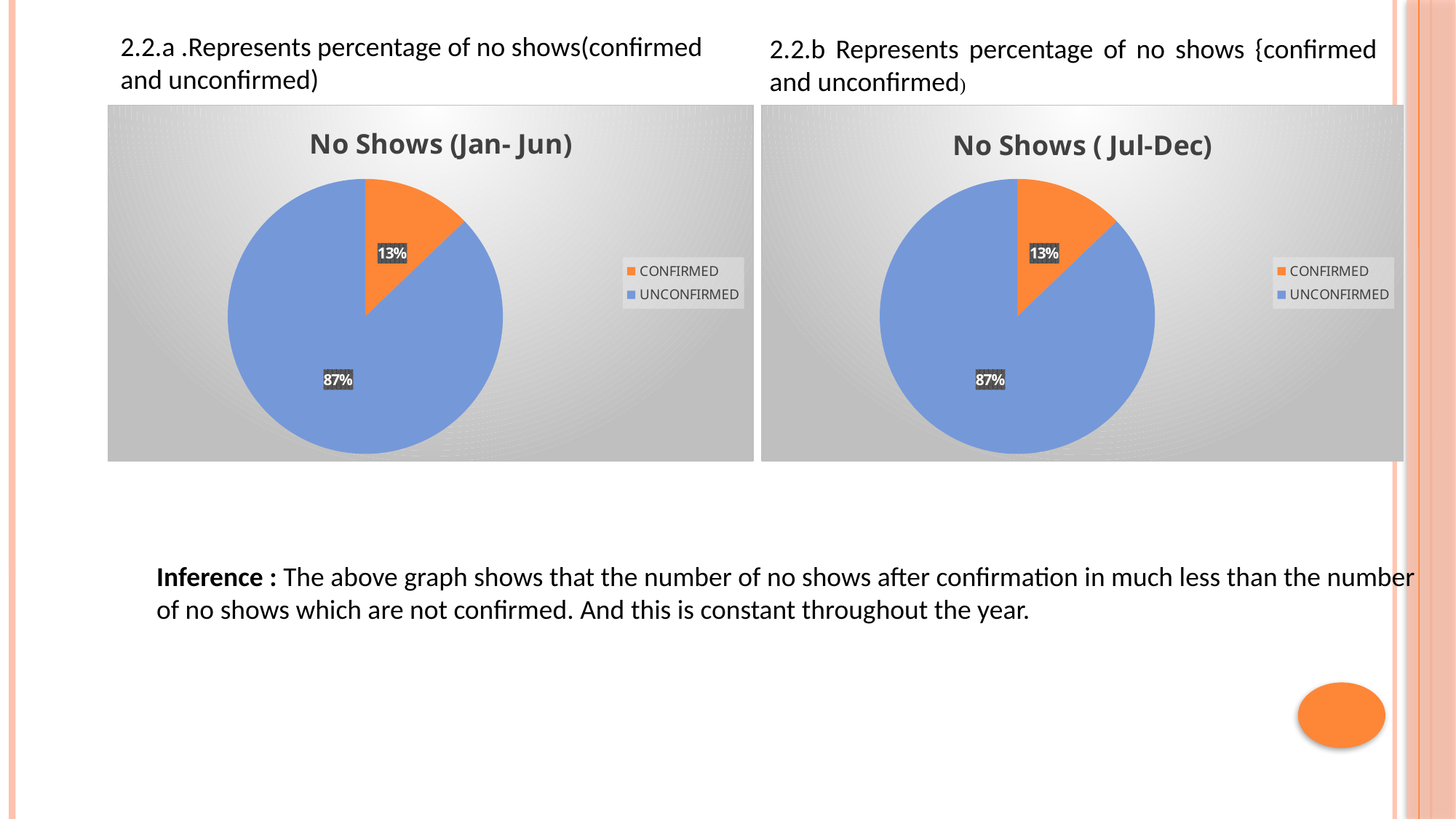
In the 'No Shows (Jan- Jun)' chart, which category has the largest slice? UNCONFIRMED In the 'No Shows ( Jul-Dec)' chart, what percentage is shown for UNCONFIRMED? 87% In the 'No Shows (Jan- Jun)' chart, what percentage is shown for CONFIRMED? 13% In the 'No Shows ( Jul-Dec)' chart, what colour is the UNCONFIRMED slice? Blue How many entries does the legend of the 'No Shows (Jan- Jun)' chart list? 2 In the 'No Shows ( Jul-Dec)' chart, which is larger, CONFIRMED or UNCONFIRMED? UNCONFIRMED In the 'No Shows (Jan- Jun)' chart, what is the difference in percentage points between UNCONFIRMED and CONFIRMED? 74 In the 'No Shows ( Jul-Dec)' chart, which category has the smallest slice? CONFIRMED How many slices does the 'No Shows ( Jul-Dec)' pie chart have? 2 In the 'No Shows ( Jul-Dec)' chart, what percentage is shown for CONFIRMED? 13% What type of chart is the 'No Shows (Jan- Jun)' chart? Pie chart In the 'No Shows (Jan- Jun)' chart, what percentage is shown for UNCONFIRMED? 87%